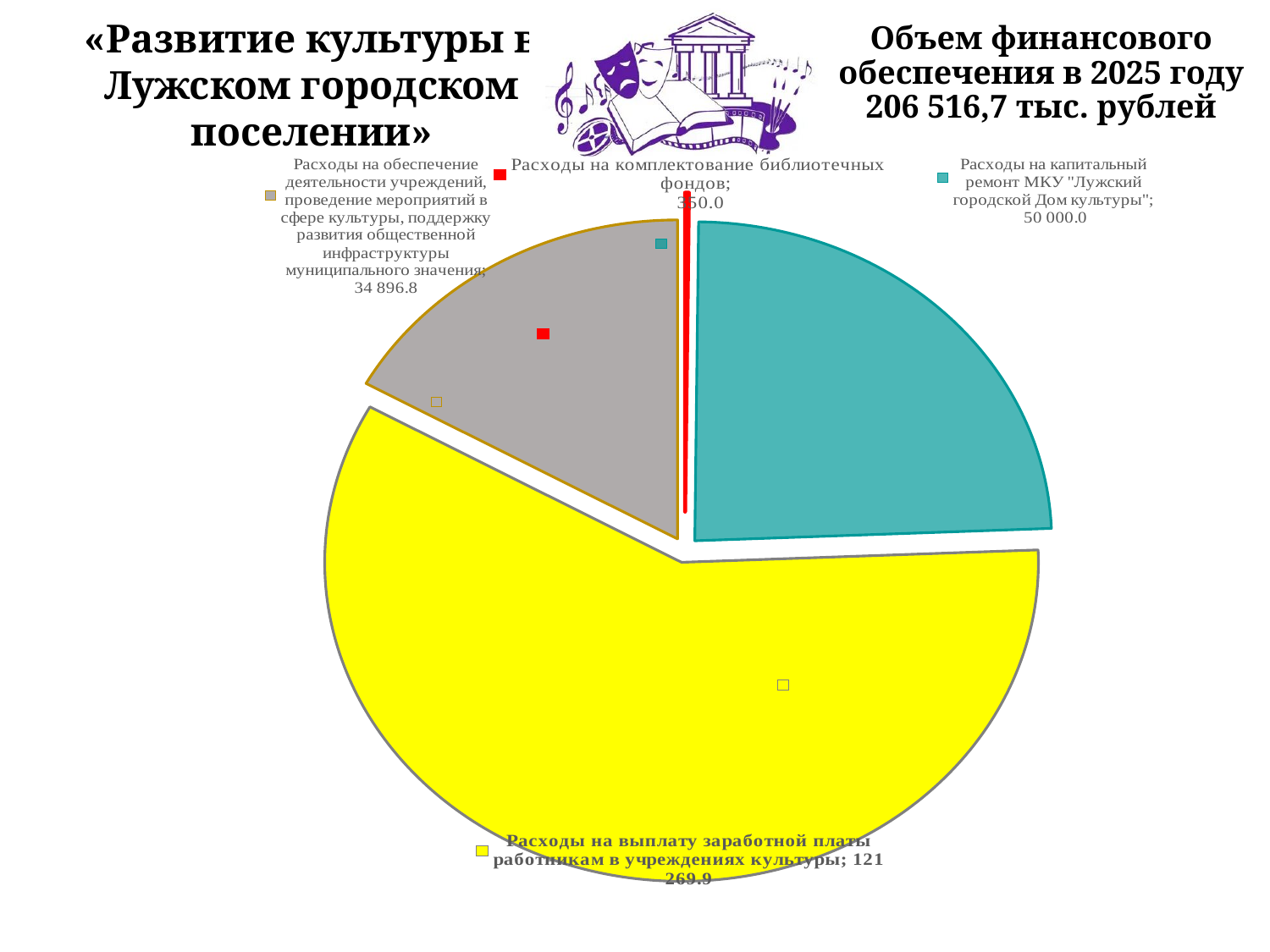
What type of chart is shown on the slide? pie chart What total amount of financial support for 2025 is stated on the slide? 206 516,7 тыс. рублей How many slices does the pie chart have? 4 What colour is the slice for "Расходы на выплату заработной платы работникам в учреждениях культуры"? yellow Which category has the largest slice of the pie? Расходы на выплату заработной платы работникам в учреждениях культуры What is the difference between the value for salary expenses (121 269.9) and the value for capital repair of the House of Culture (50 000.0)? 71 269.9 What is the difference between the value for capital repair (50 000.0) and the value for ensuring the activities of institutions (34 896.8)? 15 103.2 What is the value for "Расходы на выплату заработной платы работникам в учреждениях культуры"? 121 269.9 Which category has the smallest slice of the pie? Расходы на комплектование библиотечных фондов Which is larger: the value for capital repair of the House of Culture or the value for ensuring the activities of institutions? Расходы на капитальный ремонт МКУ "Лужский городской Дом культуры" What is the value for "Расходы на обеспечение деятельности учреждений, проведение мероприятий в сфере культуры, поддержку развития общественной инфраструктуры муниципального значения"? 34 896.8 What is the value for "Расходы на капитальный ремонт МКУ "Лужский городской Дом культуры""? 50 000.0